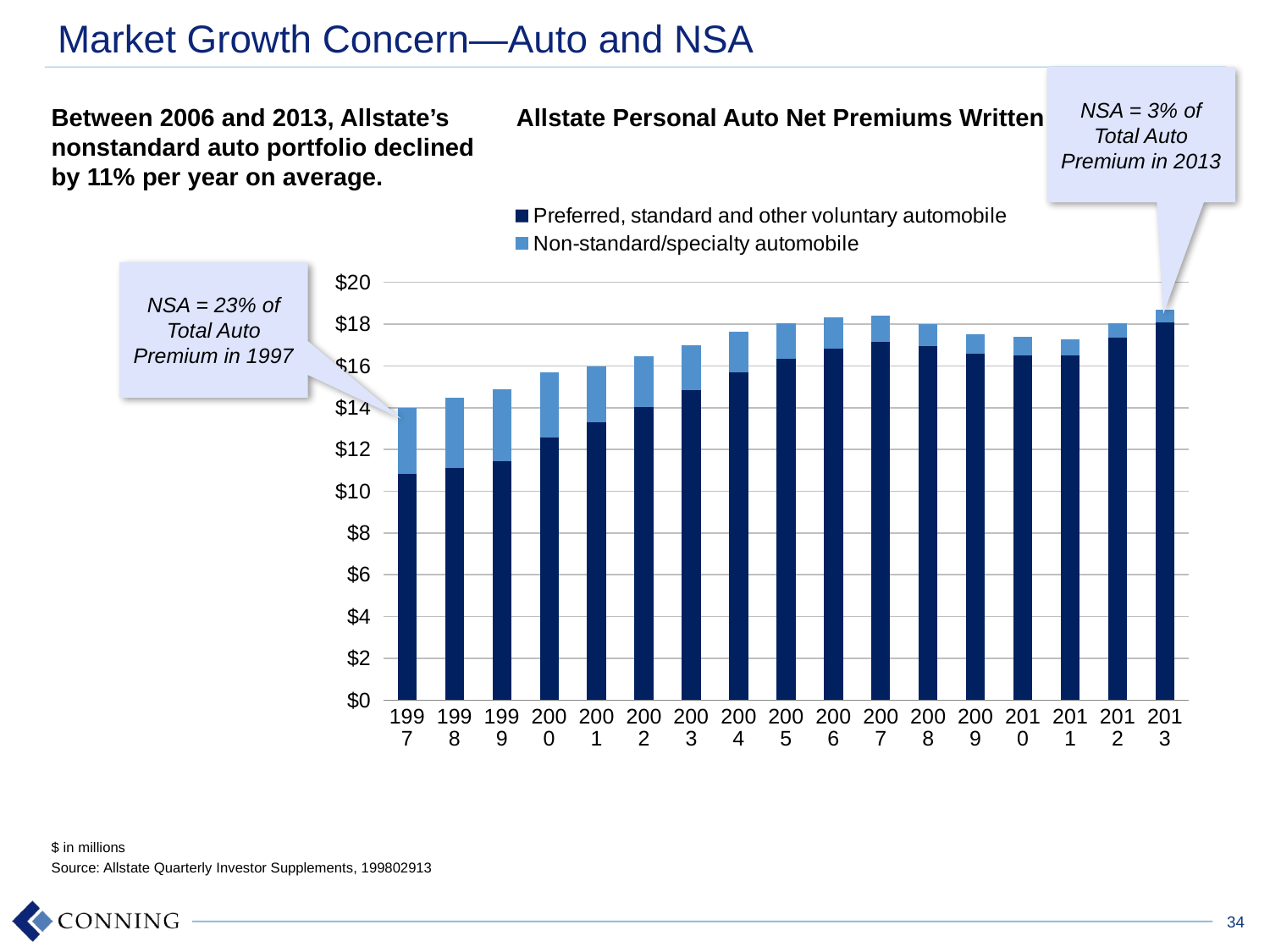
What is the title of the chart? Allstate Personal Auto Net Premiums Written Is the total net premiums written for 2013 greater or less than $18? greater Does the Preferred, standard and other voluntary automobile series rise or fall from 1997 to 2007? rise Is the total net premiums written for 2000 greater or less than $16? less Which is larger, the Non-standard/specialty automobile segment in 1997 or in 2013? 1997 Which year has the largest Non-standard/specialty automobile segment? 1999 What kind of chart is shown on the slide? Stacked bar chart How many years are shown on the x axis? 17 Which year has the lowest total net premiums written? 1997 Is the Preferred, standard and other voluntary automobile value for 1997 greater or less than $10? greater How many series does the legend list? 2 Which year has the highest value for Preferred, standard and other voluntary automobile? 2013